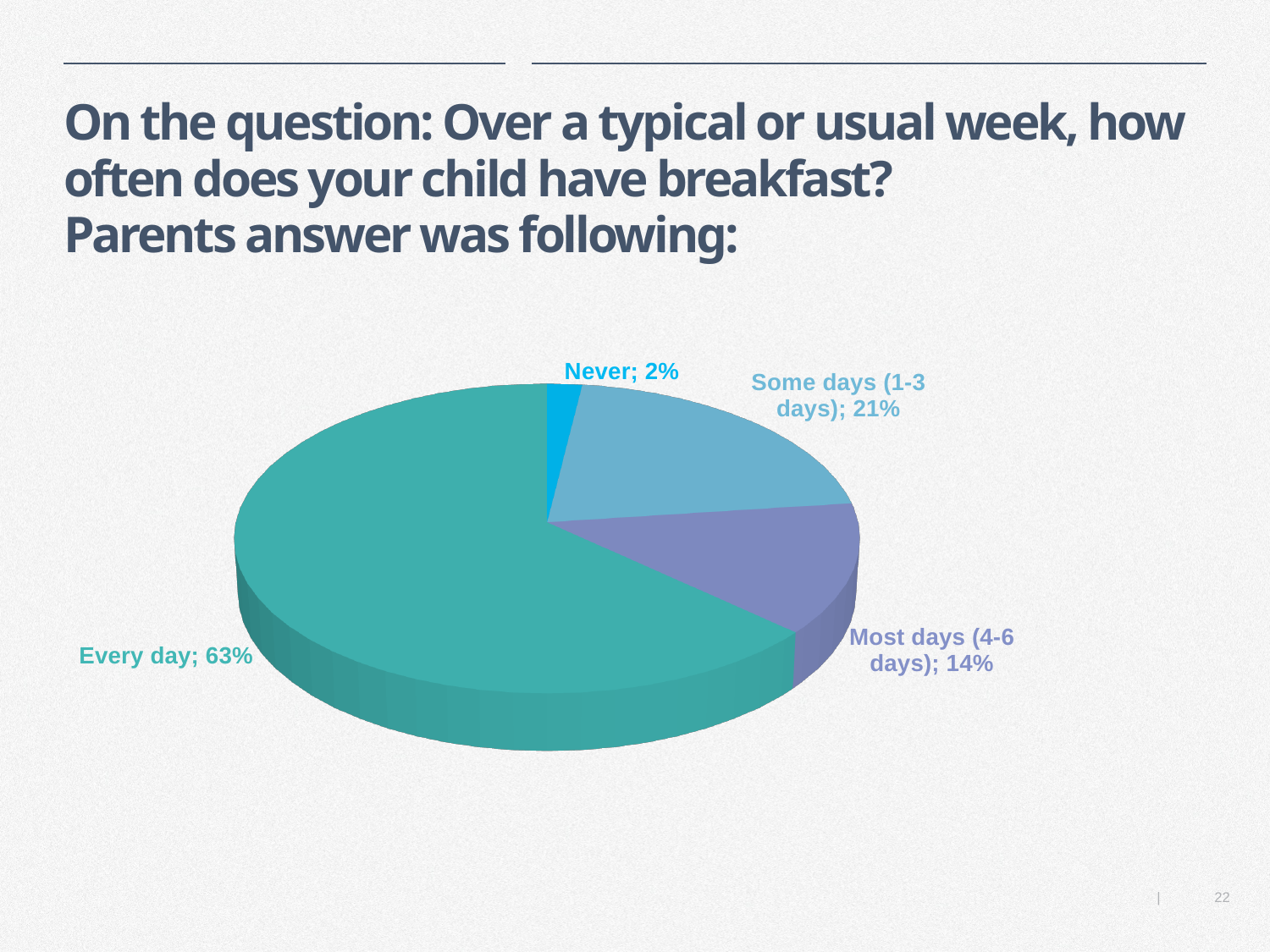
What kind of chart is shown on the slide? Pie chart Which answer has the largest share of the pie? Every day What percentage of parents answered "Some days (1-3 days)"? 21% What percentage of parents answered "Every day"? 63% What is the difference in percentage points between "Some days (1-3 days)" and "Most days (4-6 days)"? 7 How many answer categories are shown in the pie chart? 4 What is the difference in percentage points between "Every day" and "Some days (1-3 days)"? 42 What percentage of parents answered "Never"? 2% Which answer has the smallest share of the pie? Never What colour is the "Every day" slice? Teal What percentage of parents answered "Most days (4-6 days)"? 14% Which is larger: the share for "Most days (4-6 days)" or the share for "Some days (1-3 days)"? Some days (1-3 days)